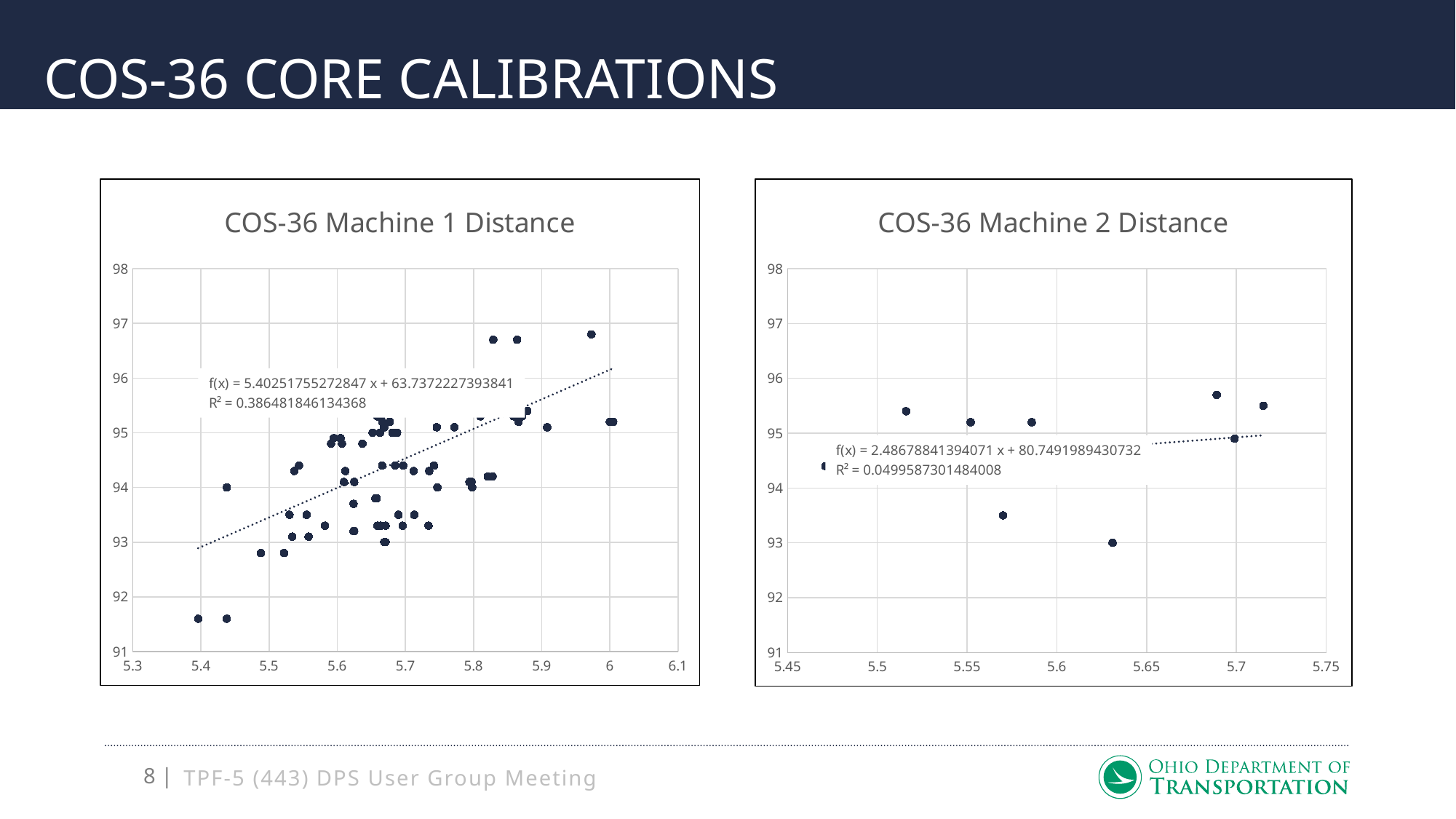
In the "COS-36 Machine 2 Distance" chart, what is the largest value shown on the x axis? 5.75 In the "COS-36 Machine 1 Distance" chart, is the highest plotted point greater or less than 96? greater What kind of chart is the "COS-36 Machine 2 Distance" chart? scatter chart In the "COS-36 Machine 2 Distance" chart, is the lowest plotted point greater or less than 94? less Which chart shows the higher R² value, "COS-36 Machine 1 Distance" or "COS-36 Machine 2 Distance"? COS-36 Machine 1 Distance In the "COS-36 Machine 1 Distance" chart, what are the lowest and highest values shown on the y axis? 91 and 98 In the "COS-36 Machine 2 Distance" chart, what is the constant term in the printed trendline equation? 80.7491989430732 In the "COS-36 Machine 2 Distance" chart, what R² value is printed for the trendline? 0.0499587301484008 What kind of chart is the "COS-36 Machine 1 Distance" chart? scatter chart In the "COS-36 Machine 1 Distance" chart, what is the slope (coefficient of x) in the printed trendline equation? 5.40251755272847 In the "COS-36 Machine 1 Distance" chart, does the dotted trendline rise or fall as x increases? rise In the "COS-36 Machine 1 Distance" chart, what R² value is printed for the trendline? 0.386481846134368